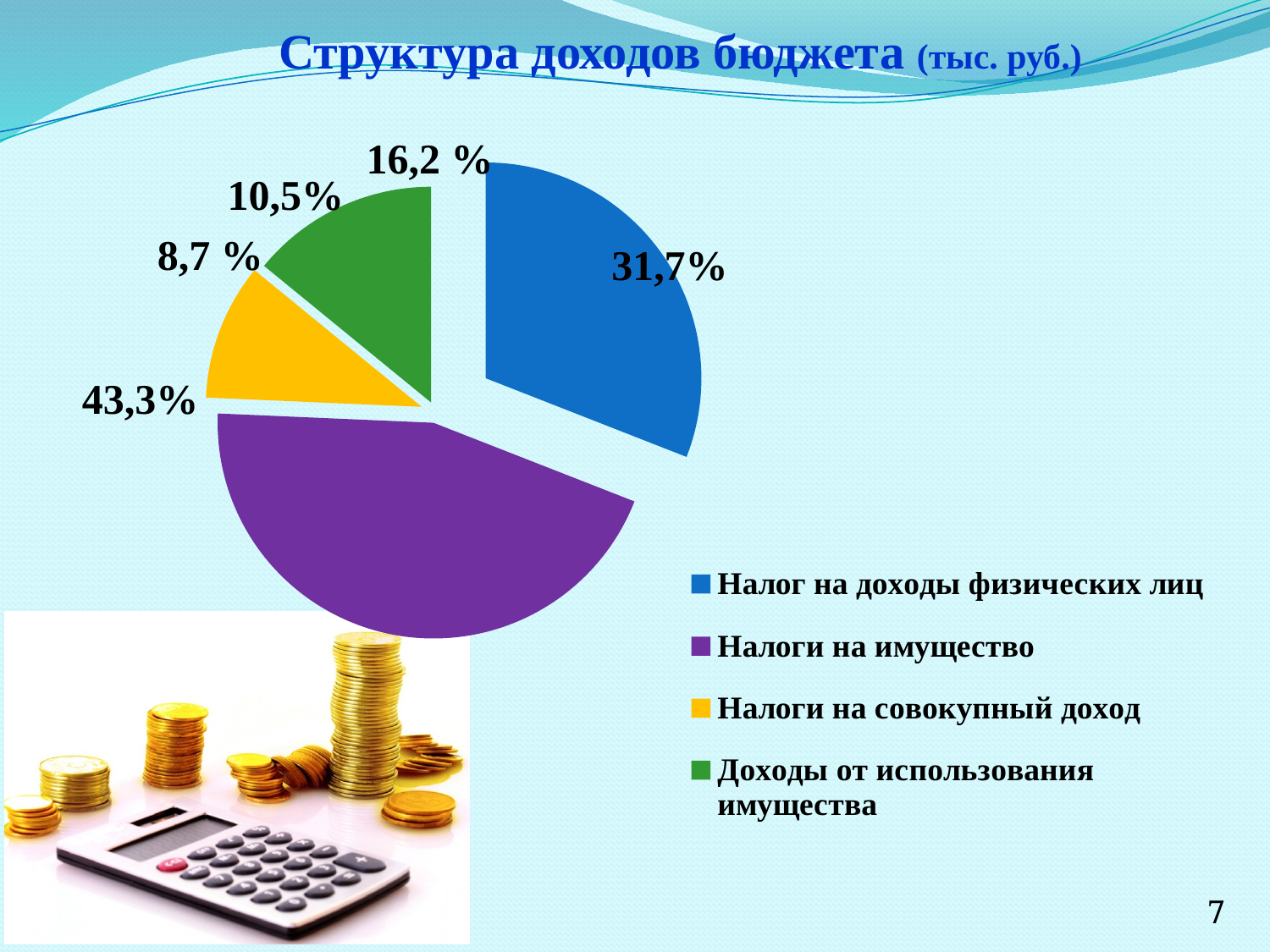
Which is larger: the slice for Налог на доходы физических лиц or the slice for Налоги на имущество? Налоги на имущество What share of the pie is labelled for Налог на доходы физических лиц? 31,7% What colour is the slice for Налоги на совокупный доход? Yellow Which is larger: the slice for Налоги на совокупный доход or the slice for Налог на доходы физических лиц? Налог на доходы физических лиц Which category has the largest slice of the pie? Налоги на имущество What is the title of the chart? Структура доходов бюджета (тыс. руб.) What share of the pie is labelled for Налоги на совокупный доход? 8,7 % By how many percentage points does the Налоги на имущество slice exceed the Налог на доходы физических лиц slice? 11,6 What share of the pie is labelled for Налоги на имущество? 43,3% What kind of chart is shown on the slide? Pie chart How many entries does the legend list? 4